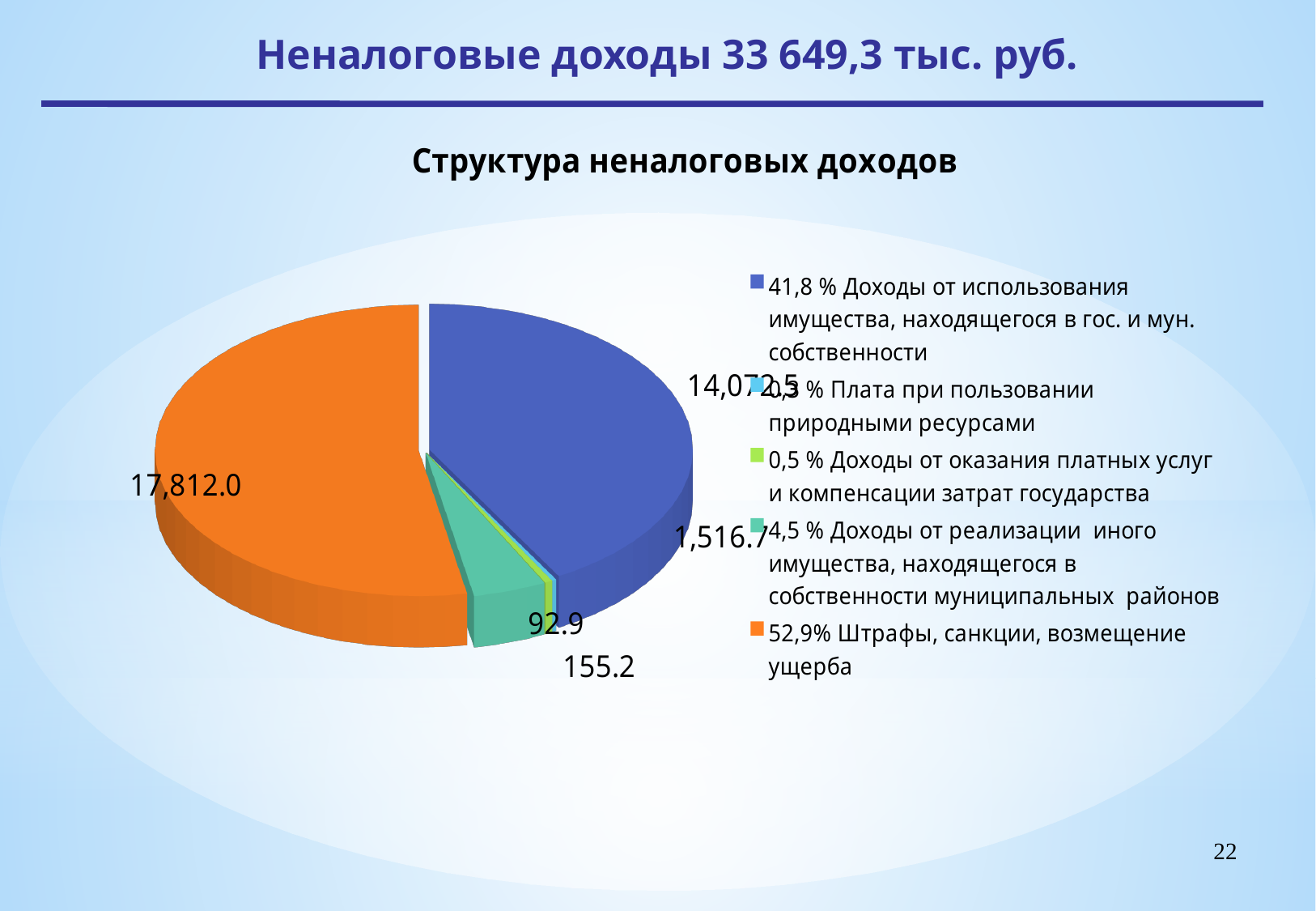
What is the value shown for Доходы от реализации иного имущества, находящегося в собственности муниципальных районов? 1,516.7 How many categories does the pie chart have? 5 What share of the pie does Плата при пользовании природными ресурсами represent? 0,3 % What is the difference between the value for Штрафы, санкции, возмещение ущерба and the value for Доходы от использования имущества? 3,739.5 What is the value shown for Штрафы, санкции, возмещение ущерба? 17,812.0 What kind of chart is shown on the slide? Pie chart What share of the pie does Штрафы, санкции, возмещение ущерба represent? 52,9% Which category has the largest slice of the pie? Штрафы, санкции, возмещение ущерба Which category has the smallest share according to the legend? Плата при пользовании природными ресурсами What is the value shown for Доходы от использования имущества, находящегося в гос. и мун. собственности? 14,072.5 Which is larger: the value for Штрафы, санкции, возмещение ущерба or the value for Доходы от использования имущества? Штрафы, санкции, возмещение ущерба What share of the pie does Доходы от использования имущества, находящегося в гос. и мун. собственности represent? 41,8 %